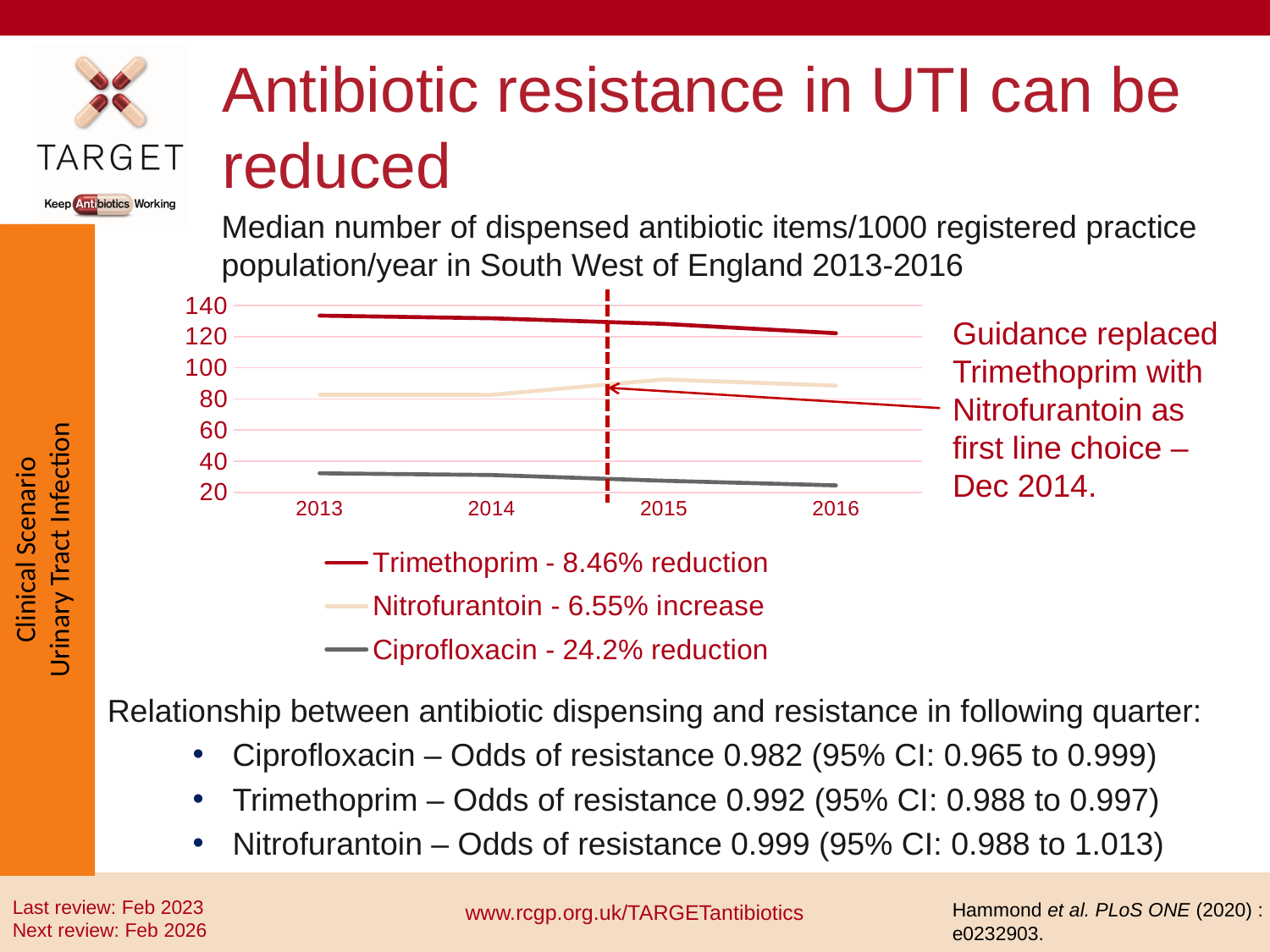
Is the value for Nitrofurantoin in 2013 greater or less than 100? less What kind of chart is shown on the slide? line chart How many series does the chart's legend list? 3 According to the legend, what percentage change is given for Nitrofurantoin? 6.55% increase Is the value for Ciprofloxacin in 2016 greater or less than 40? less Does the Trimethoprim line rise or fall from 2013 to 2016? fall Is the Nitrofurantoin value larger in 2013 or in 2015? 2015 Is the value for Trimethoprim in 2013 greater or less than 120? greater Does the Ciprofloxacin line rise or fall from 2013 to 2016? fall How many years are shown along the x axis of the chart? 4 Which antibiotic has the lowest median number of dispensed items across all years shown? Ciprofloxacin Which antibiotic has the highest median number of dispensed items across all years shown? Trimethoprim